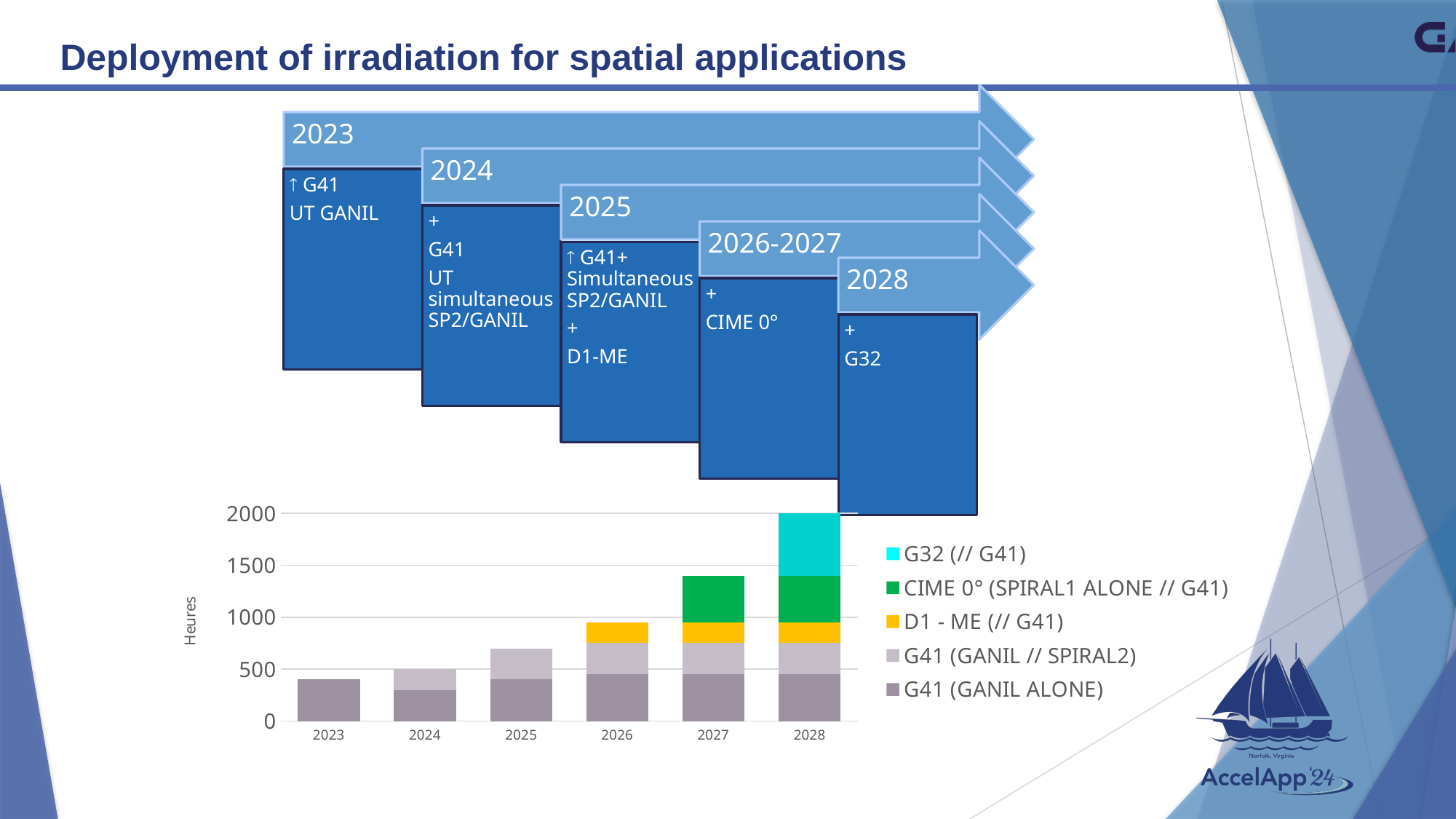
Is the total value for 2027 greater or less than 1000? greater What kind of chart is shown on the slide? Stacked bar chart Which year has the tallest stacked bar? 2028 Is the total value for 2023 greater or less than 500? less Which year has the shortest stacked bar? 2023 What is the label on the vertical axis of the chart? Heures Which year has a taller total bar, 2027 or 2025? 2027 Which series is shown in cyan in the chart legend? G32 (// G41) How many years (categories) are shown on the x axis of the chart? 6 Do the total bar heights rise or fall from 2023 to 2028? Rise Is the total value for 2025 greater or less than 1000? less How many series does the chart legend list? 5